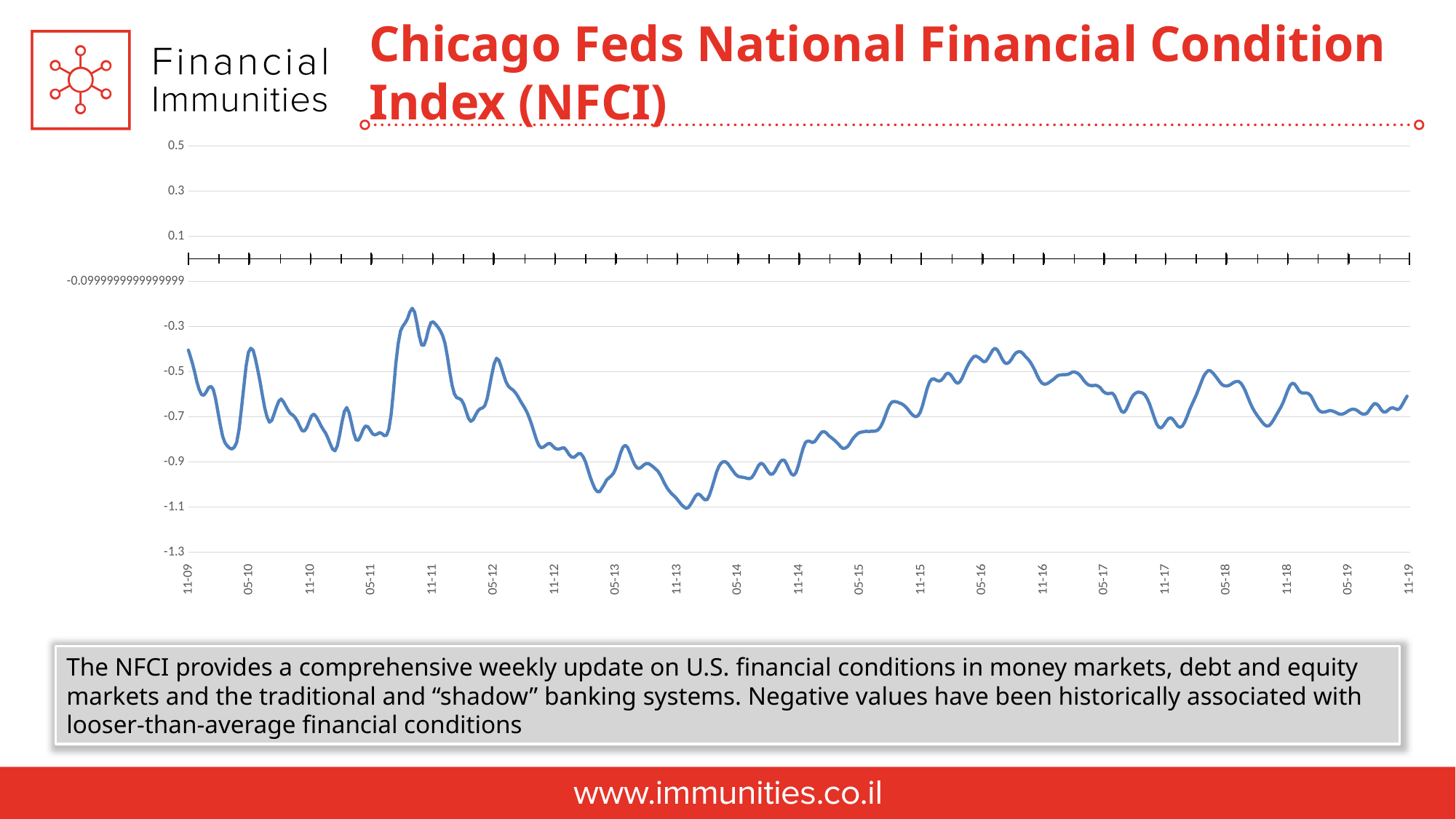
How many date labels are shown along the x axis? 21 What colour is the plotted line? blue Is the value at 11-19 greater or less than -0.7? greater Around which x-axis label does the line reach its lowest point? 11-13 What is the title of the slide's chart? Chicago Feds National Financial Condition Index (NFCI) Is the value at 11-11 greater or less than -0.5? greater Which is larger, the value at 11-09 or the value at 11-13? 11-09 What kind of chart is shown on the slide? line chart Between 11-13 and 05-16, does the line generally rise or fall? rise Is the value at 11-09 greater or less than -0.5? greater